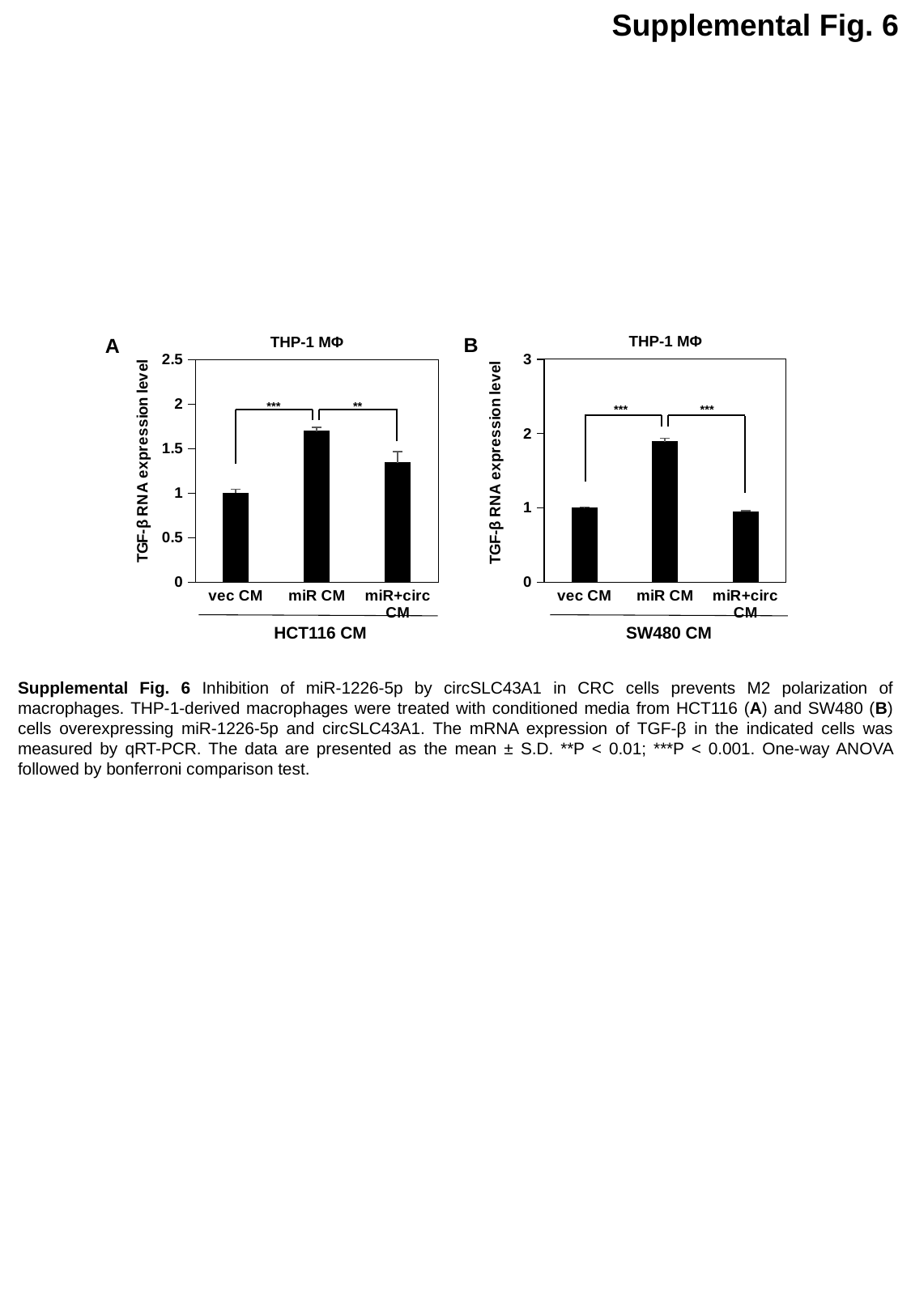
In chart B (SW480 CM), is the value for miR CM greater or less than 1.5? greater In chart A (HCT116 CM), is the value for miR CM greater or less than 1.5? greater In chart A (HCT116 CM), is the value for miR+circ CM greater or less than 1? greater How many categories are shown on the x axis of chart B (SW480 CM)? 3 What is the title shown above chart B (SW480 CM)? THP-1 MΦ In chart A (HCT116 CM), which category has the lowest TGF-β RNA expression level? vec CM In chart B (SW480 CM), which category has the highest TGF-β RNA expression level? miR CM In chart A (HCT116 CM), what is the TGF-β RNA expression level for vec CM? 1 In chart A (HCT116 CM), which category has the highest TGF-β RNA expression level? miR CM In chart B (SW480 CM), which is larger, the value for vec CM or the value for miR CM? miR CM In chart A (HCT116 CM), which is larger, the value for miR CM or the value for miR+circ CM? miR CM What kind of chart is chart A (HCT116 CM)? bar chart